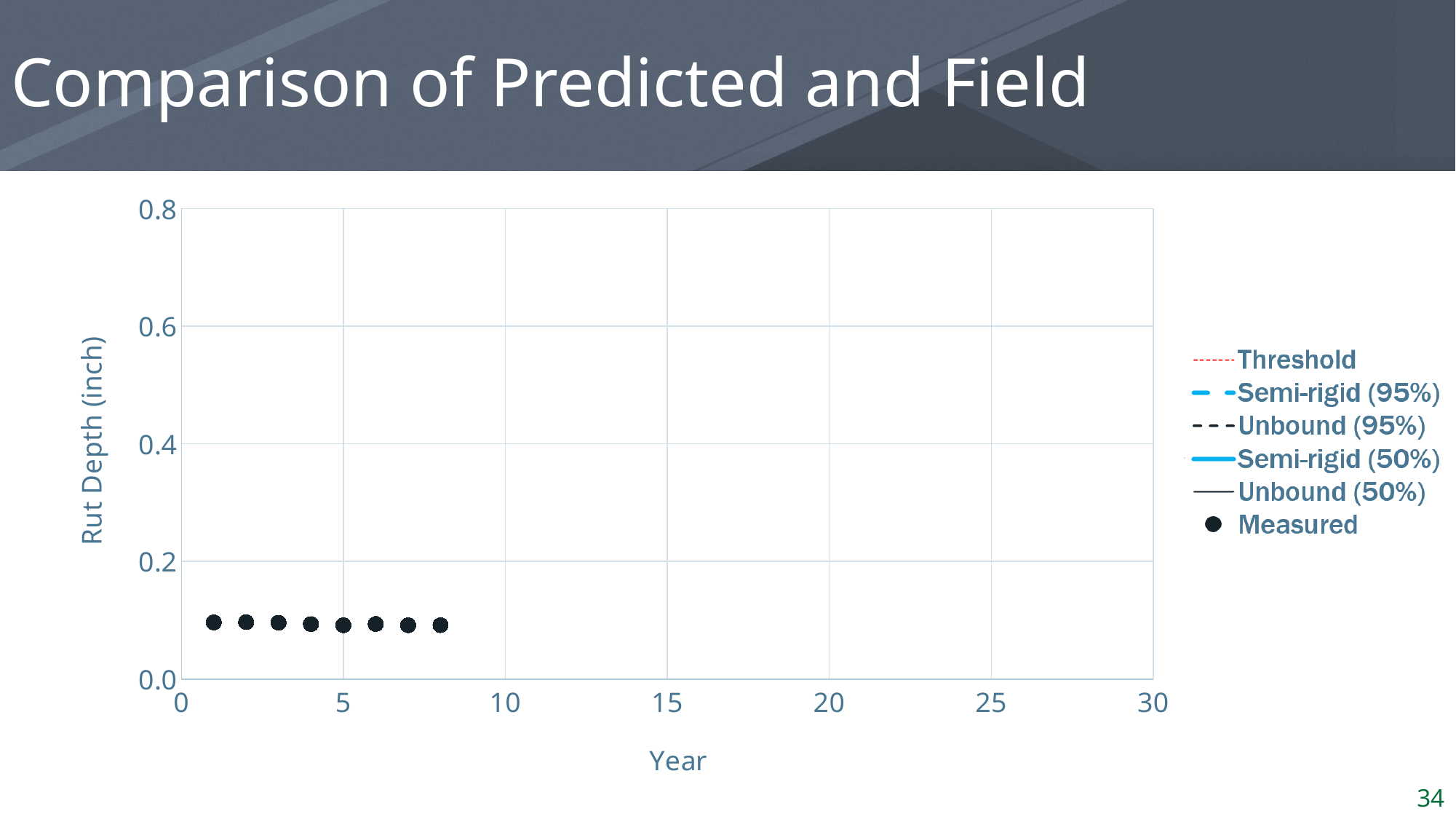
How many series does the legend list? 6 What is the label of the vertical axis? Rut Depth (inch) How many Measured data points are plotted on the chart? 8 What kind of chart is shown on the slide? scatter chart Is the Measured rut depth at year 8 greater or less than 0.2? less Which legend entry is drawn with a red dotted line? Threshold Is the Measured rut depth at year 3 greater or less than 0.6? less Is the Measured rut depth at year 1 greater or less than 0.2? less